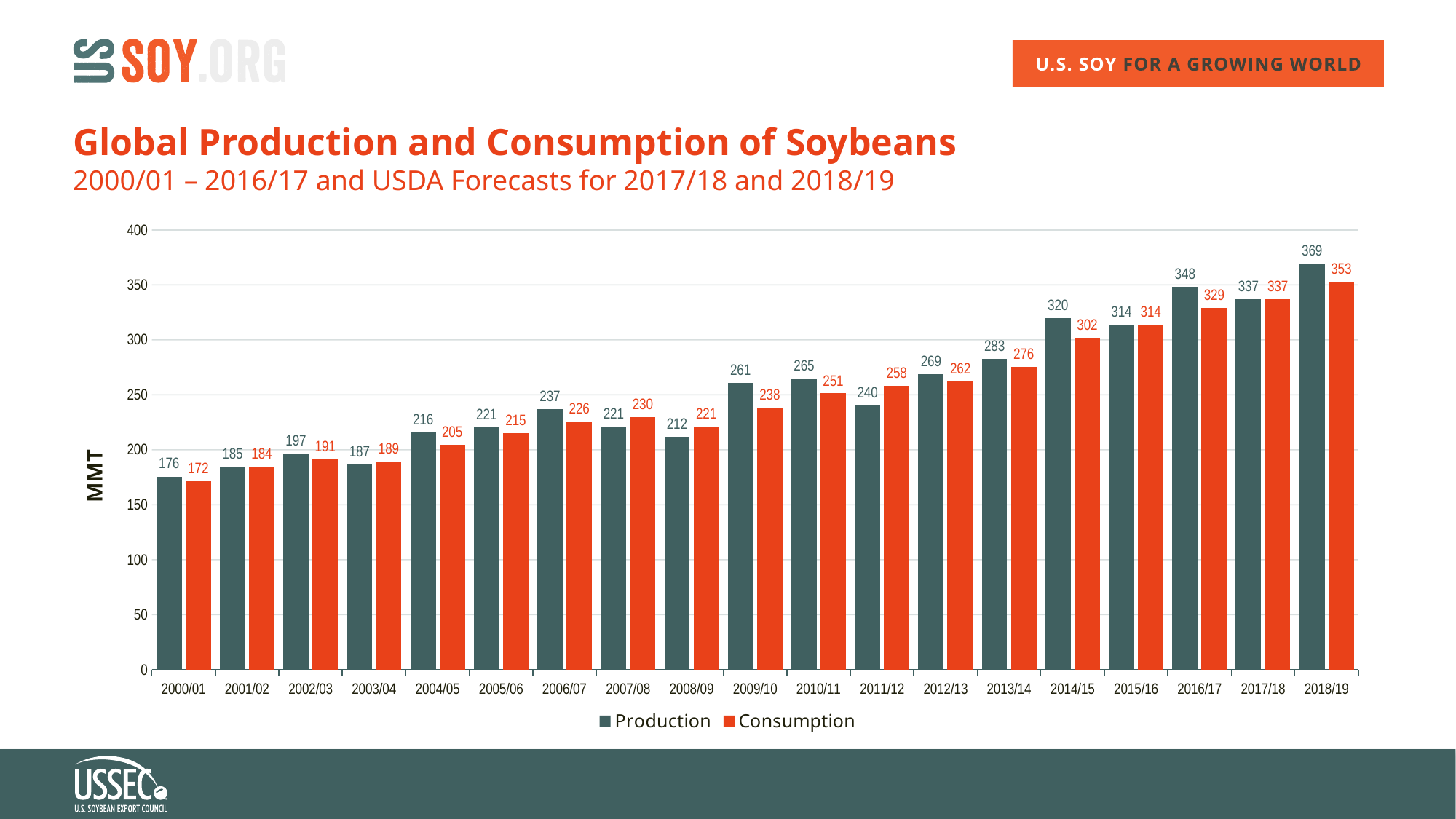
Is the Production value for 2013/14 greater or less than 250? greater What kind of chart is shown on the slide? bar chart Which year has the lowest Consumption value? 2000/01 Do Production values generally rise or fall from 2000/01 to 2018/19? rise Which year has the highest Production value? 2018/19 Which is larger in 2011/12, Production or Consumption? Consumption What is the Production value for 2009/10? 261 What is the Consumption value for 2014/15? 302 What is the label on the y axis? MMT What is the difference between Production and Consumption in 2016/17? 19 How many series does the legend list? 2 How many years are shown on the x axis? 19